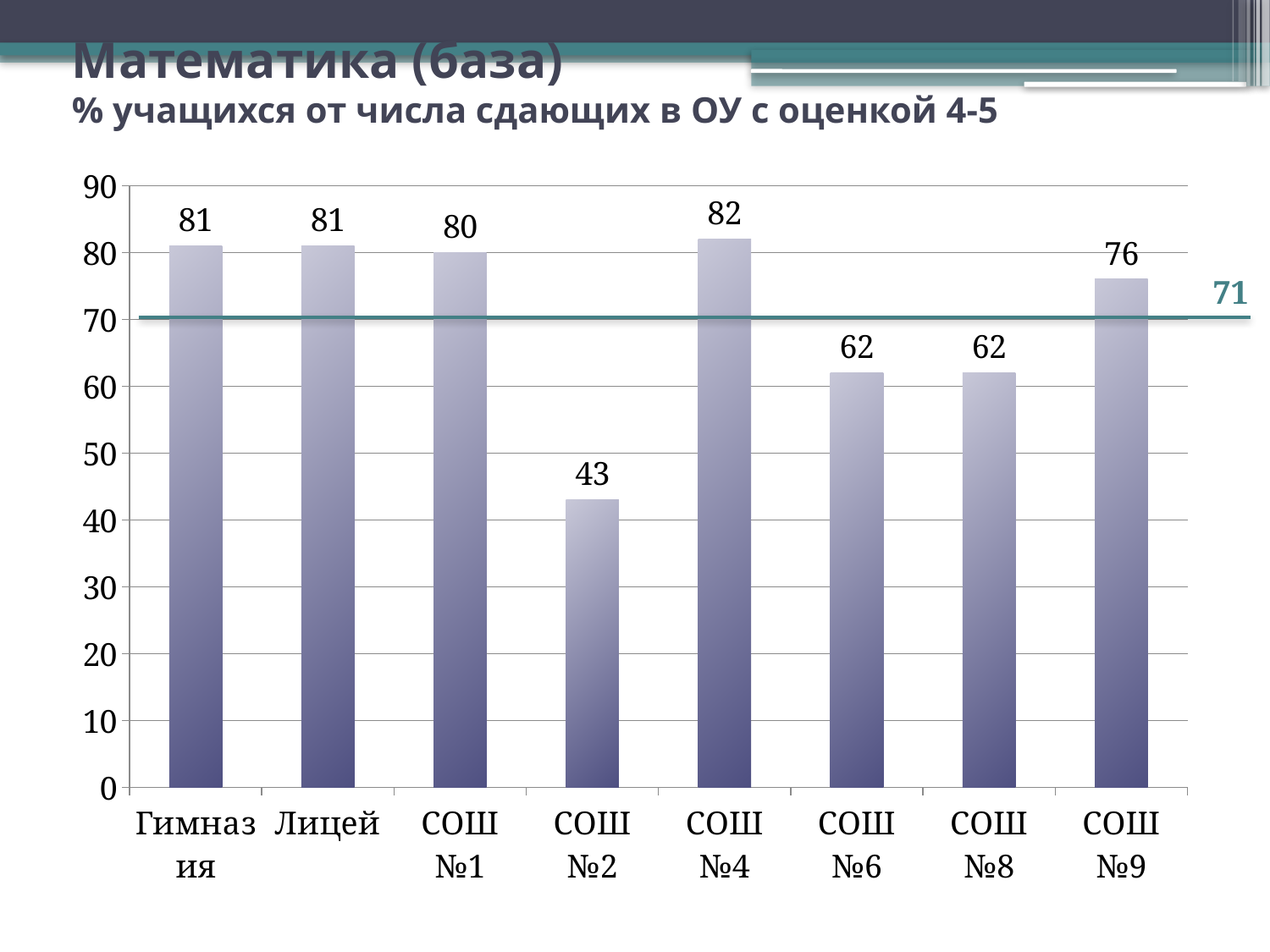
What is the value for СОШ №2? 43 Is the value for СОШ №6 greater or less than 70? less Which category has the highest value? СОШ №4 Which category has the lowest value? СОШ №2 What value is labelled on the horizontal line drawn across the chart? 71 What is the value for СОШ №9? 76 What is the difference between the values for Гимназия and СОШ №6? 19 What is the value for СОШ №4? 82 What kind of chart is shown on the slide? bar chart What is the difference between the values for СОШ №4 and СОШ №2? 39 Which is larger, the value for СОШ №9 or the value for СОШ №8? СОШ №9 How many categories are shown on the x axis? 8